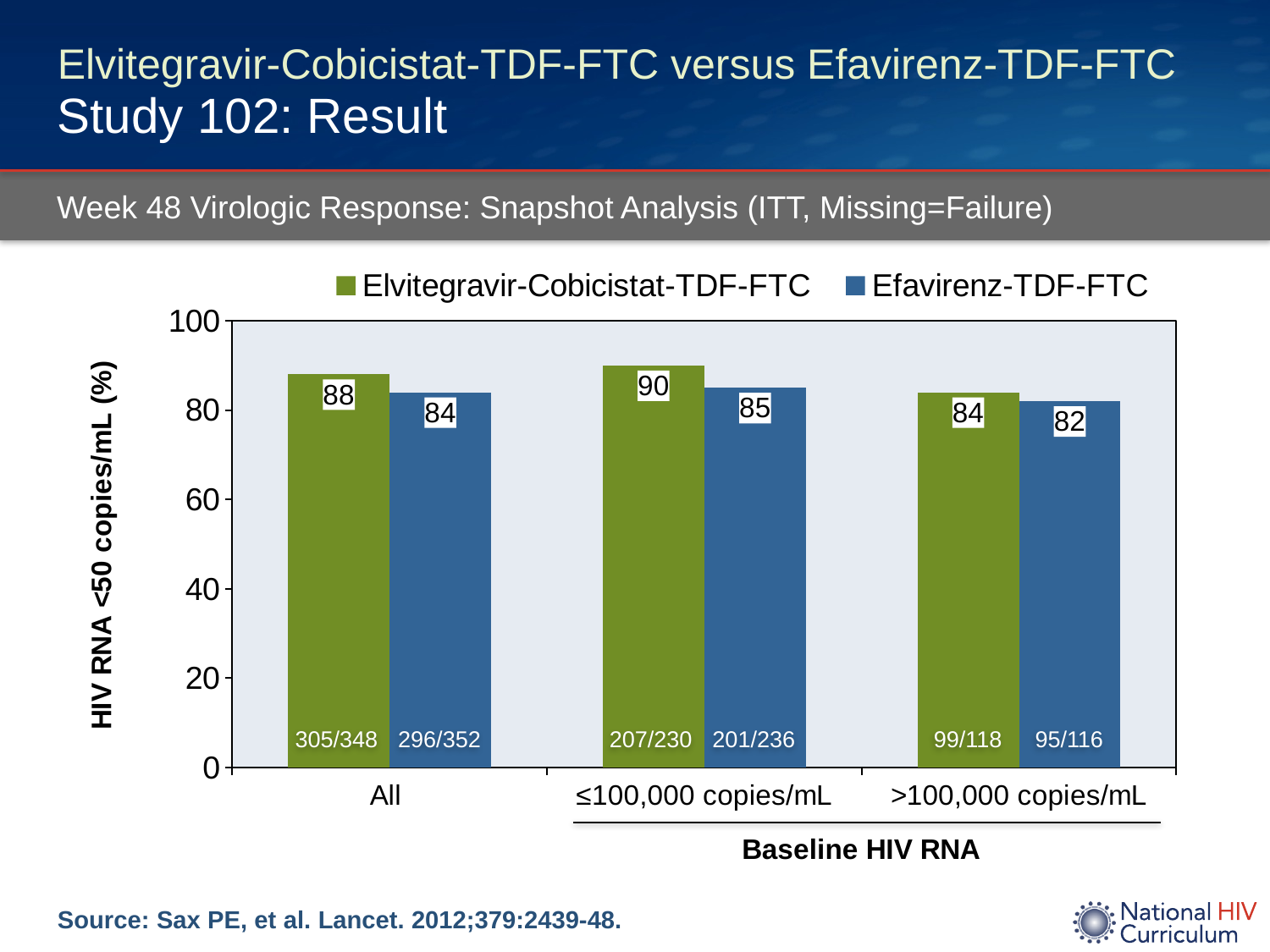
How many series does the legend list? 2 What is the y-axis label of the chart? HIV RNA <50 copies/mL (%) How many baseline HIV RNA categories are shown on the x axis? 3 What is the value for Elvitegravir-Cobicistat-TDF-FTC in the All group? 88 What is the value for Efavirenz-TDF-FTC in the >100,000 copies/mL group? 82 What is the value for Efavirenz-TDF-FTC in the ≤100,000 copies/mL group? 85 Is the value for Efavirenz-TDF-FTC in the All group greater or less than 80? greater Which baseline HIV RNA category has the highest value for Elvitegravir-Cobicistat-TDF-FTC? ≤100,000 copies/mL In the All group, which series has the larger value, Elvitegravir-Cobicistat-TDF-FTC or Efavirenz-TDF-FTC? Elvitegravir-Cobicistat-TDF-FTC Which baseline HIV RNA category has the lowest value for Efavirenz-TDF-FTC? >100,000 copies/mL What is the difference between the Elvitegravir-Cobicistat-TDF-FTC and Efavirenz-TDF-FTC values in the ≤100,000 copies/mL group? 5 What kind of chart is shown on the slide? bar chart